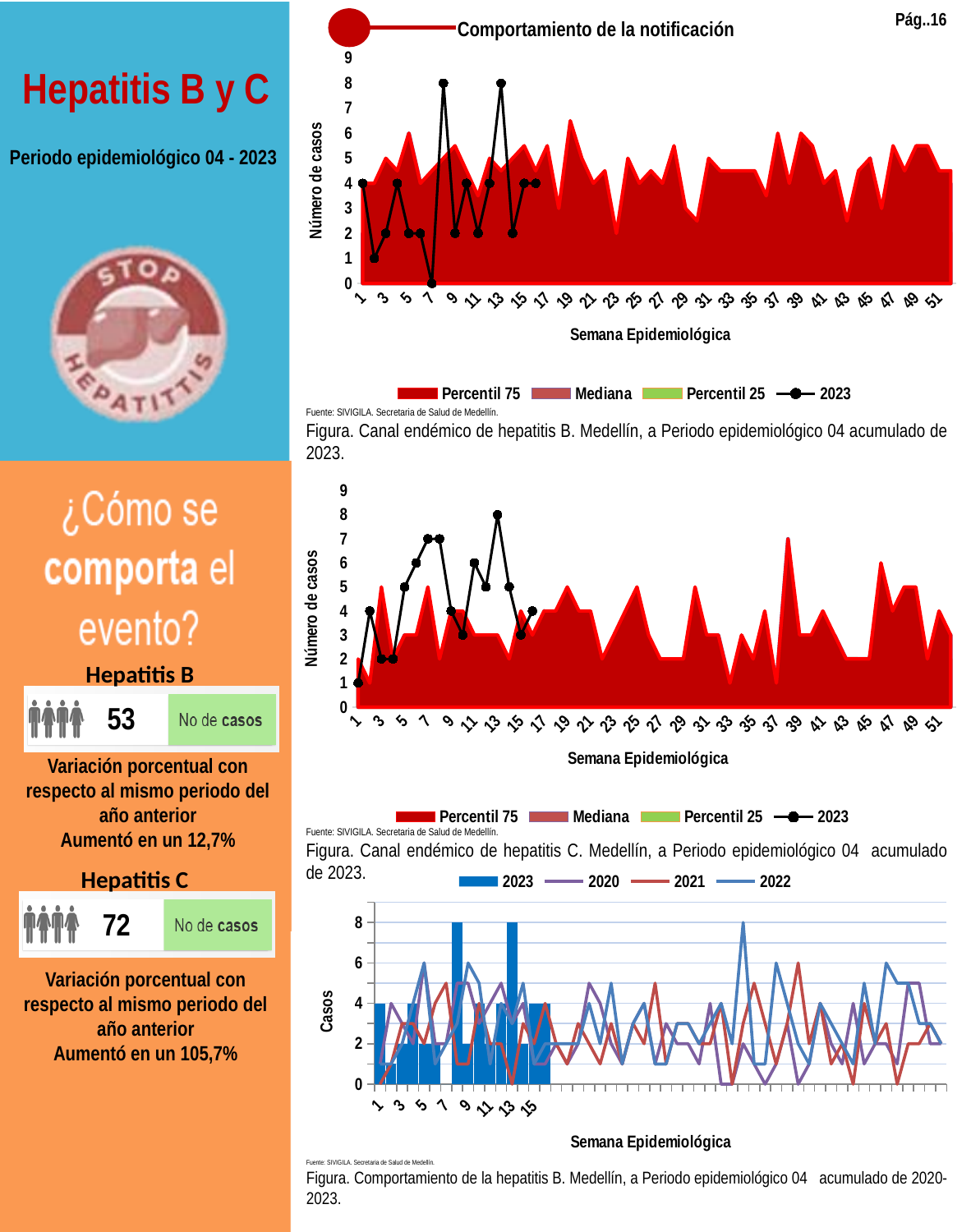
In the hepatitis B endemic channel chart (top chart), what is the title of the x axis? Semana Epidemiológica In the hepatitis C endemic channel chart (middle chart), what is the highest value reached by the 2023 series? 8 In the hepatitis C endemic channel chart (middle chart), what is the value of the 2023 series at week 7? 7 In the hepatitis B endemic channel chart (top chart), what is the highest value reached by the 2023 series? 8 In the hepatitis B endemic channel chart (top chart), what is the value of the 2023 series at week 1? 4 In the bottom chart (Comportamiento de la hepatitis B 2020-2023), what is the highest value reached by the 2023 bars? 8 In the hepatitis C endemic channel chart (middle chart), which is larger for the 2023 series: the value at week 7 or the value at week 1? week 7 In the hepatitis C endemic channel chart (middle chart), what is the title of the y axis? Número de casos In the hepatitis B endemic channel chart (top chart), what is the lowest value of the 2023 series? 0 In the bottom chart (Comportamiento de la hepatitis B 2020-2023), how many series does the legend list? 4 In the hepatitis C endemic channel chart (middle chart), what is the value of the 2023 series at week 1? 1 In the hepatitis B endemic channel chart (top chart), how many series does the legend list? 4